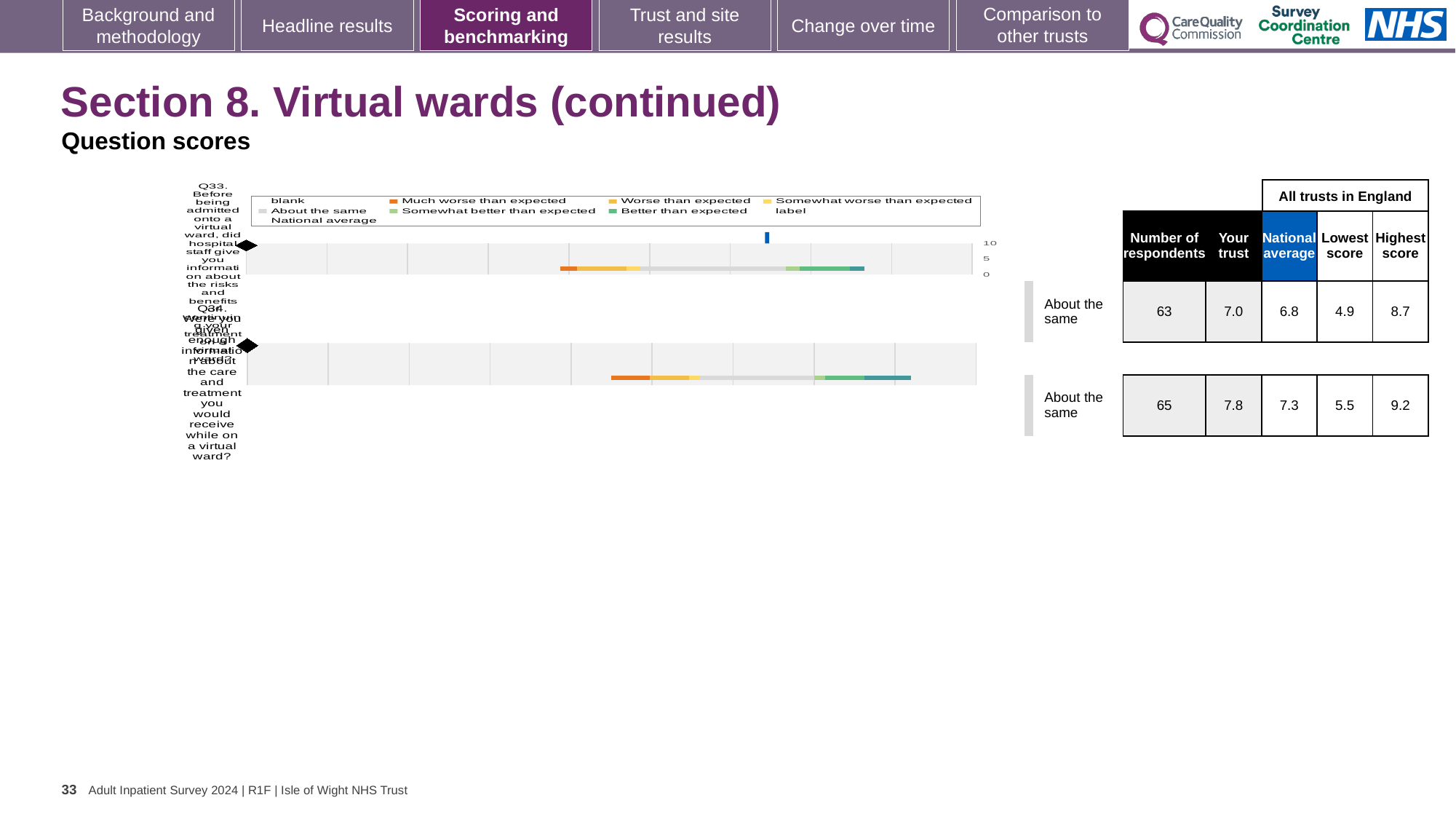
What colour represents 'Much worse than expected' in the legend? orange What is the number of respondents for Q33? 63 What is the highest score among all trusts in England for Q34? 9.2 What benchmark category is shown for both Q33 and Q34? About the same How many questions (bars) are plotted in the chart? 2 For Q33, is the 'Your trust' score higher or lower than the national average? higher Which question has the higher 'Your trust' score, Q33 or Q34? Q34 What is the national average score for Q33? 6.8 What is the 'Your trust' score for Q34? 7.8 For Q34, what is the difference between the highest score and the lowest score? 3.7 What kind of chart is shown on the slide? bar chart What is the lowest score among all trusts in England for Q33? 4.9